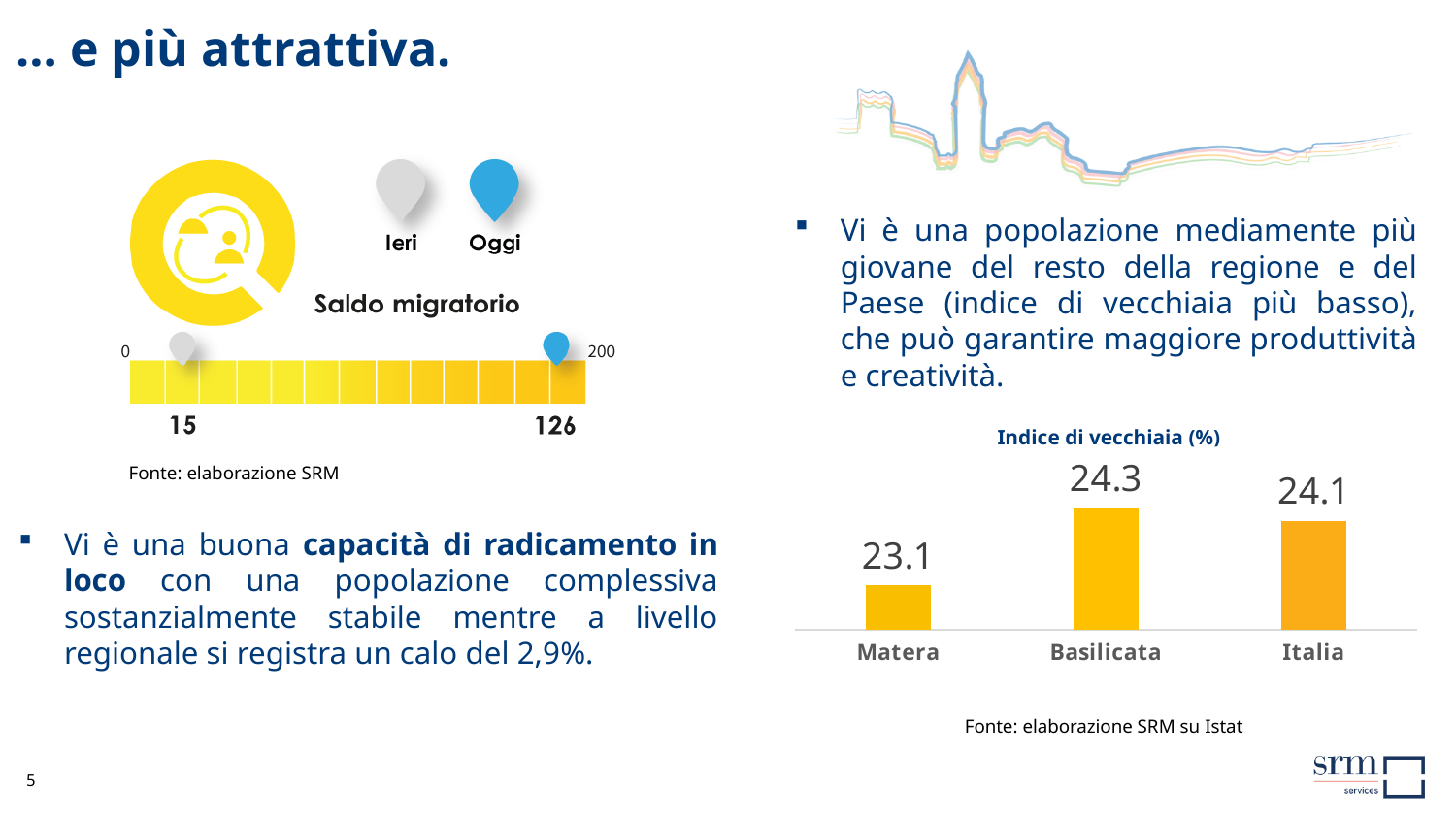
In the 'Saldo migratorio' graphic, what is the value for 'Ieri'? 15 In the 'Saldo migratorio' graphic, what is the value for 'Oggi'? 126 What kind of chart is the 'Indice di vecchiaia (%)' chart? Bar chart In the 'Indice di vecchiaia (%)' chart, which is larger, the value for Basilicata or the value for Italia? Basilicata In the 'Indice di vecchiaia (%)' chart, what is the value for Italia? 24.1 What is the title of the bar chart on the right side of the slide? Indice di vecchiaia (%) In the 'Indice di vecchiaia (%)' chart, what is the difference between the values for Basilicata and Matera? 1.2 In the 'Indice di vecchiaia (%)' chart, what is the value for Matera? 23.1 How many categories are shown in the 'Indice di vecchiaia (%)' chart? 3 In the 'Indice di vecchiaia (%)' chart, what is the value for Basilicata? 24.3 In the 'Indice di vecchiaia (%)' chart, which category has the highest value? Basilicata In the 'Indice di vecchiaia (%)' chart, which category has the lowest value? Matera